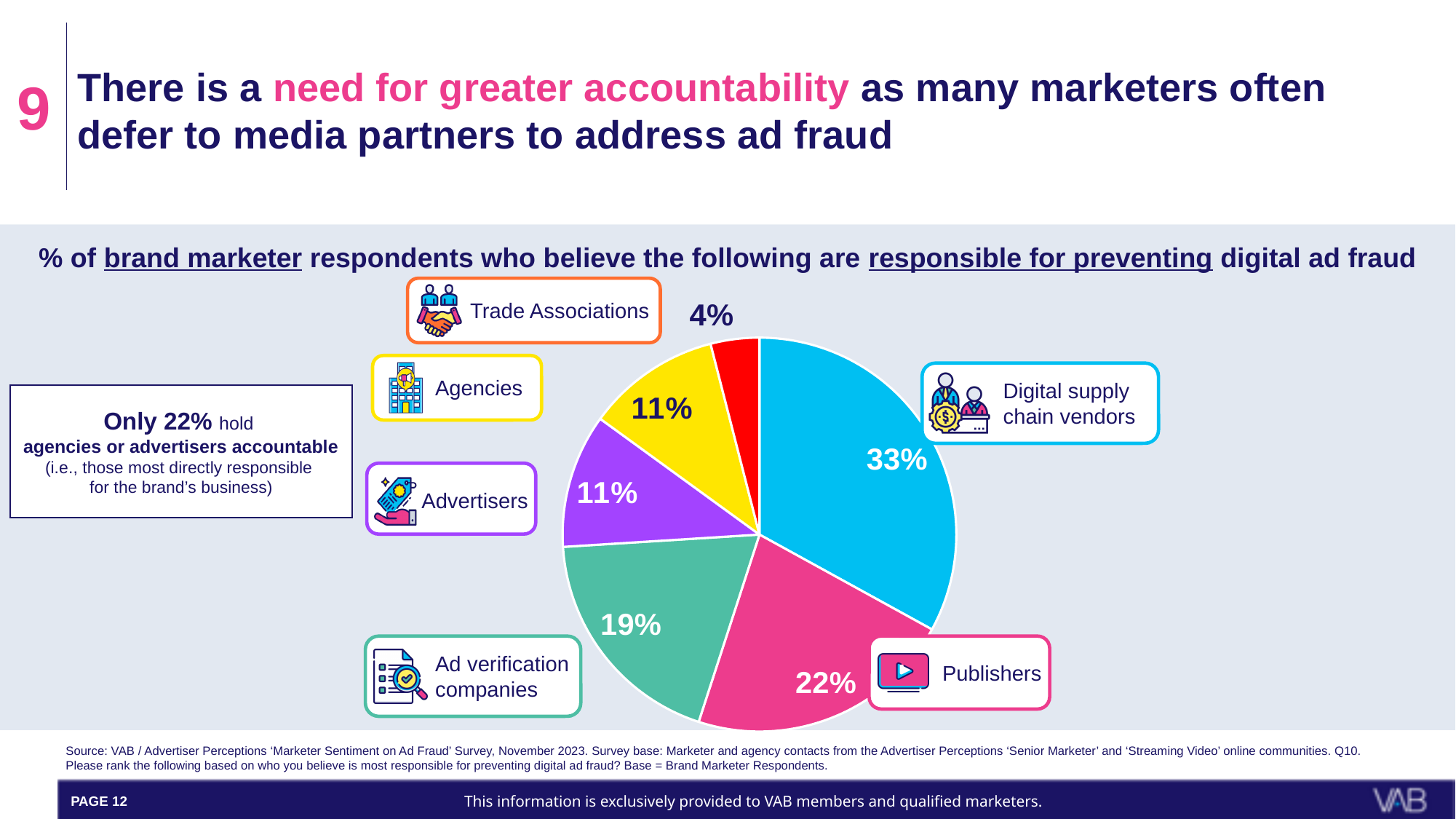
What colour is the slice representing publishers? Pink What percentage of respondents believe advertisers are responsible for preventing digital ad fraud? 11% How many categories are shown in the pie chart? 6 What percentage of respondents believe publishers are responsible for preventing digital ad fraud? 22% What is the difference in percentage points between digital supply chain vendors and publishers? 11 What type of chart is shown on the slide? Pie chart What share of the pie is attributed to ad verification companies? 19% Which category has the smallest slice of the pie chart? Trade Associations Which is larger: the share for publishers or the share for ad verification companies? Publishers Which category has the largest slice of the pie chart? Digital supply chain vendors What percentage of brand marketer respondents believe digital supply chain vendors are responsible for preventing digital ad fraud? 33% What percentage of respondents hold trade associations responsible for preventing digital ad fraud? 4%